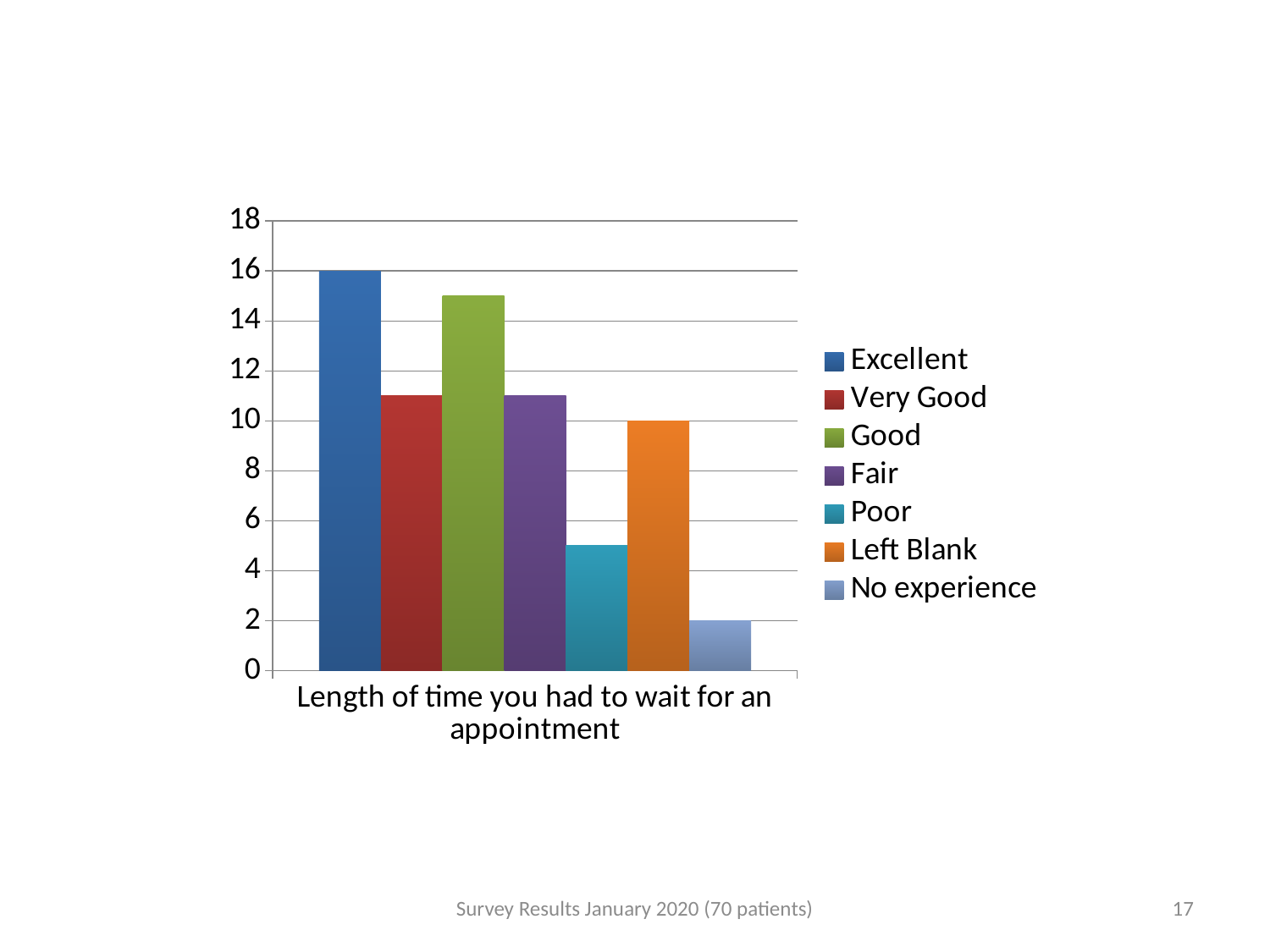
What is the difference between the values for Excellent and Left Blank? 6 Which series has the lowest value? No experience Is the value for Good greater or less than 14? greater Which is larger, the value for Poor or the value for Left Blank? Left Blank What is the difference between the values for Left Blank and No experience? 8 What is the value for Excellent? 16 How many series does the legend list? 7 Is the value for Poor greater or less than 6? less What kind of chart is shown on the slide? Bar chart What is the value for Left Blank? 10 What is the value for No experience? 2 Which series has the highest value? Excellent